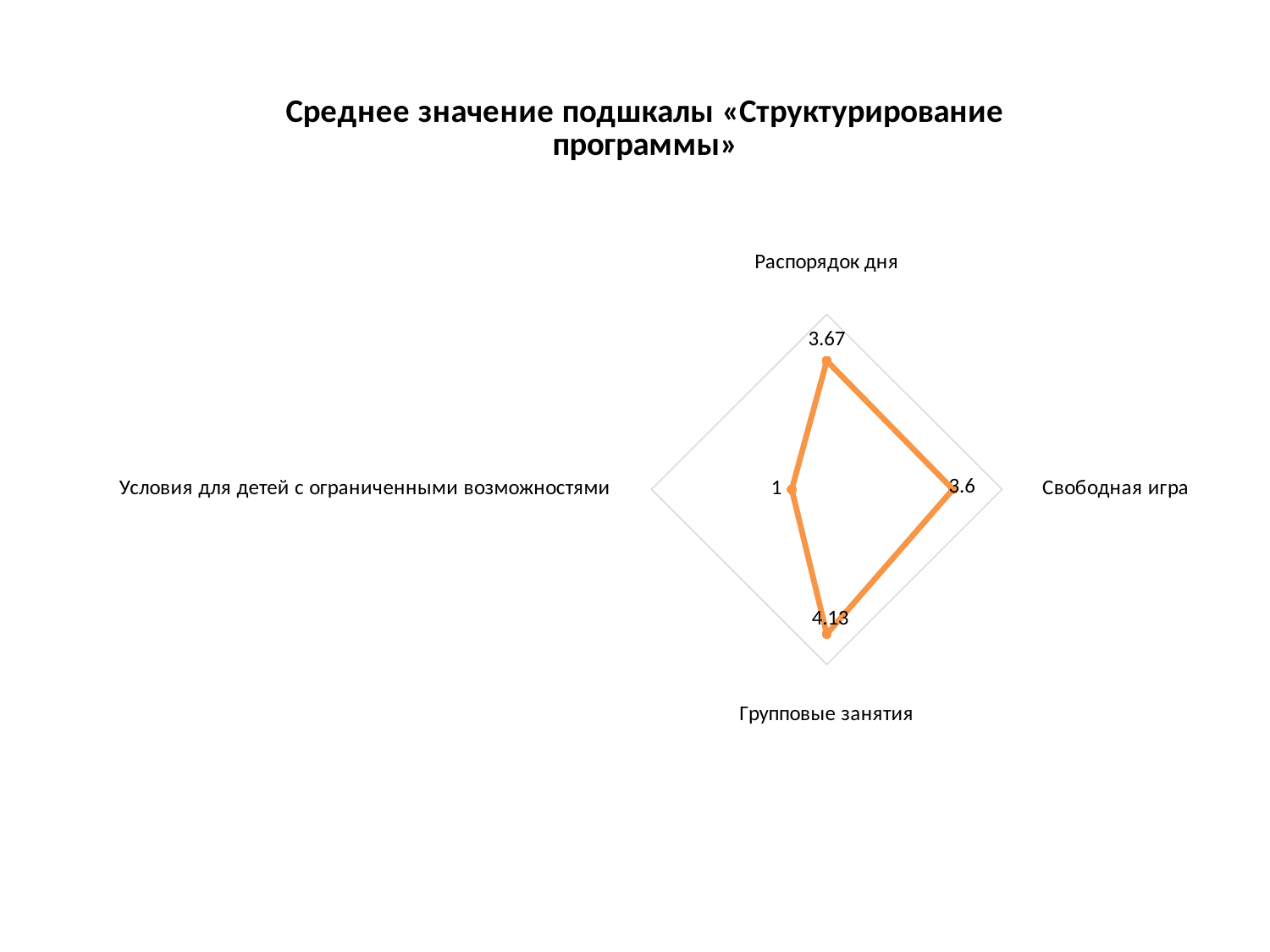
What is the difference between the values for Групповые занятия and Распорядок дня? 0.46 What is the value for Групповые занятия? 4.13 Which category has the lowest value? Условия для детей с ограниченными возможностями How many categories are plotted on the chart? 4 What is the value for Свободная игра? 3.6 What is the value for Распорядок дня? 3.67 Which category has the highest value? Групповые занятия What kind of chart is shown on the slide? Radar chart What is the value for Условия для детей с ограниченными возможностями? 1 Which is larger, the value for Групповые занятия or the value for Свободная игра? Групповые занятия What is the title of the chart? Среднее значение подшкалы «Структурирование программы» What is the difference between the values for Свободная игра and Условия для детей с ограниченными возможностями? 2.6